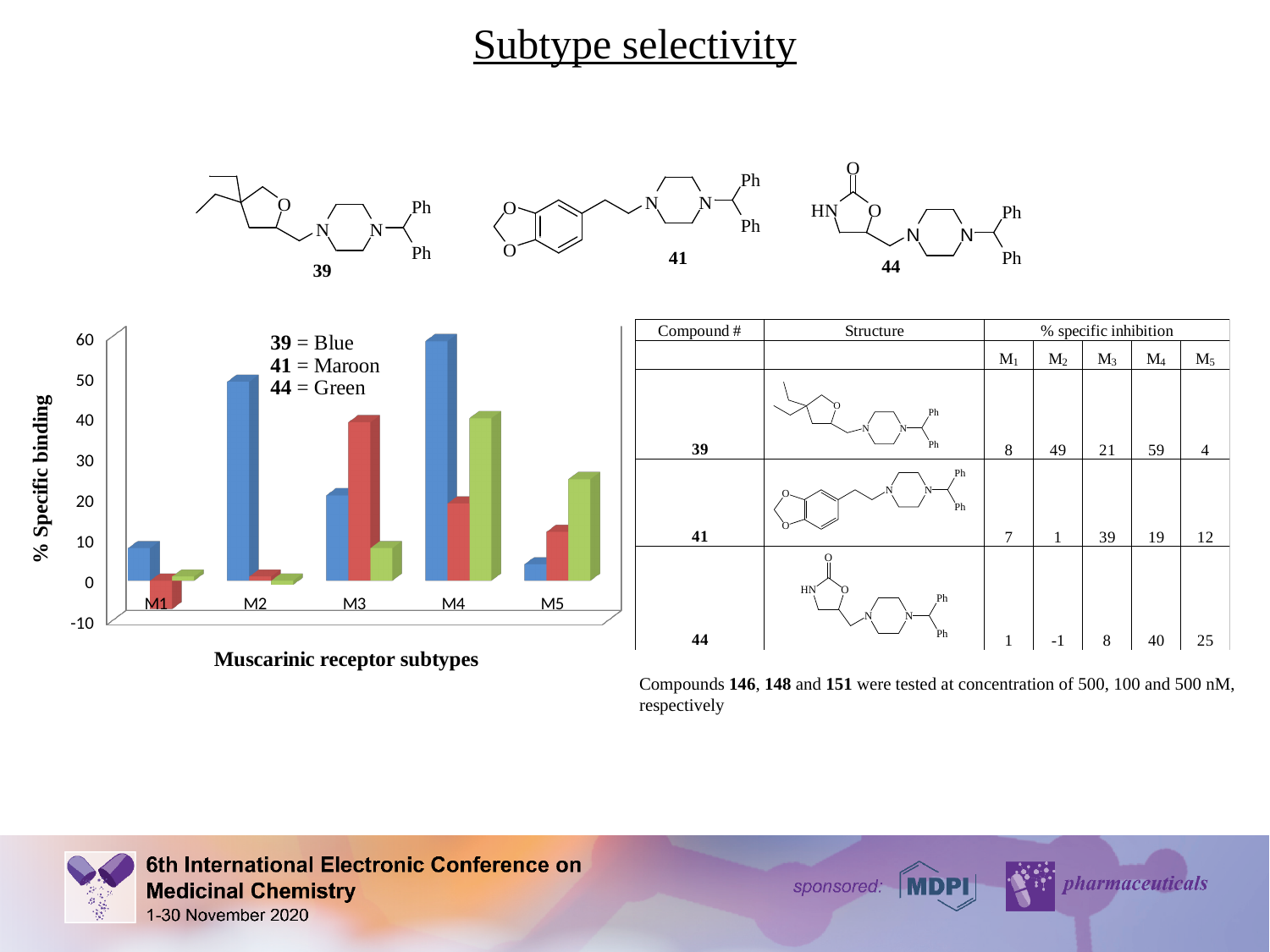
How many compounds (series) does the chart's legend list? 3 What is the title of the chart's y axis? % Specific binding At M4, which compound has the larger % specific binding, 39 (blue) or 44 (green)? 39 (blue) What kind of chart is shown on the slide? bar chart For compound 39 (blue), which receptor subtype has the highest % specific binding? M4 For compound 44 (green), which receptor subtype has the highest % specific binding? M4 At M3, which compound has the larger % specific binding, 39 (blue) or 41 (maroon)? 41 (maroon) Is the value for compound 39 (blue) at M2 greater or less than 40? greater Is the value for compound 41 (maroon) at M3 greater or less than 30? greater How many muscarinic receptor subtypes are shown on the x axis of the chart? 5 Is the value for compound 44 (green) at M5 greater or less than 20? greater For compound 41 (maroon), which receptor subtype has the highest % specific binding? M3